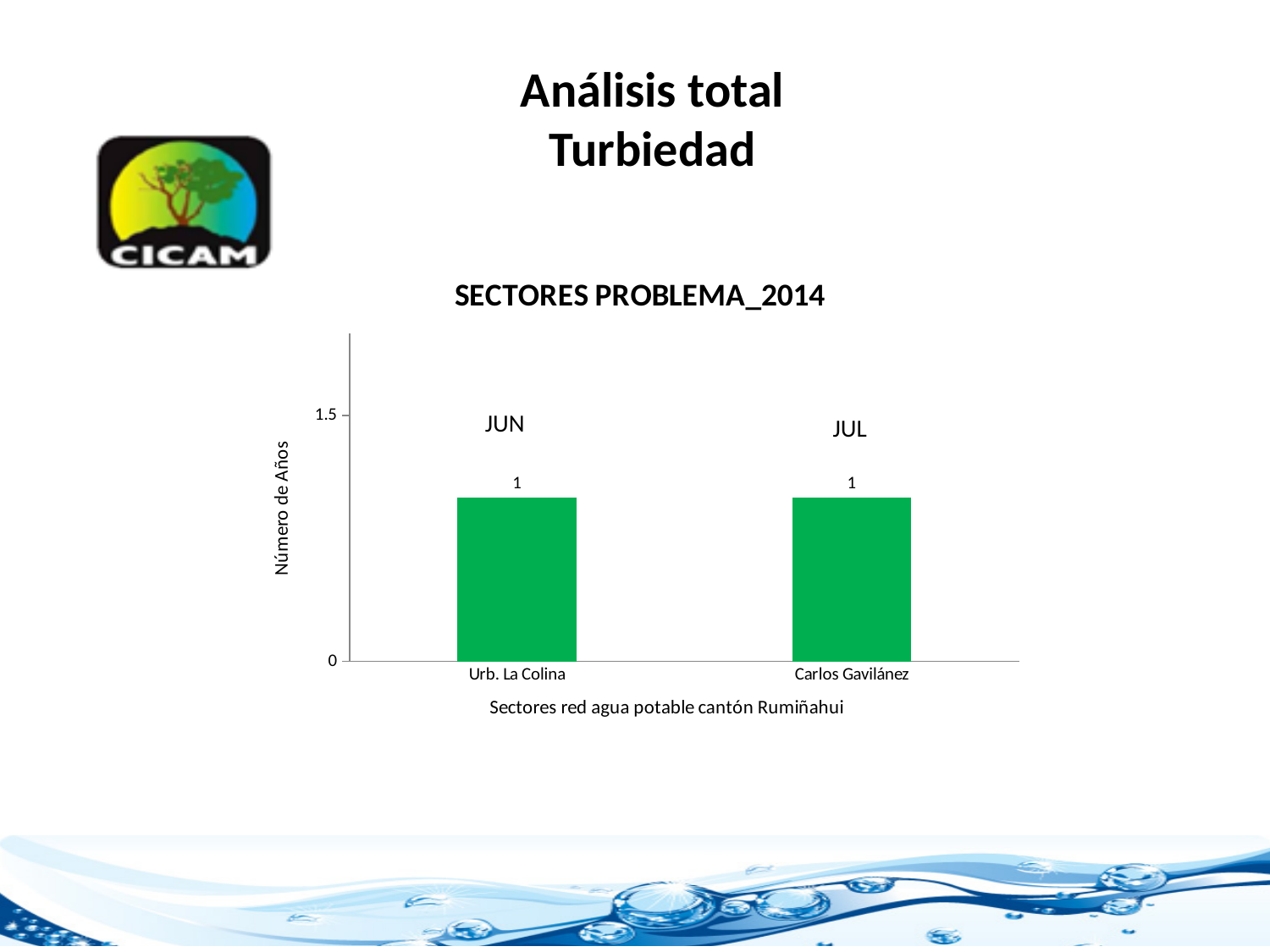
How many categories are shown on the x axis? 2 Which month label is shown above the bar for Carlos Gavilánez? JUL Is the value for Carlos Gavilánez greater or less than 1.5? less What is the title of the chart? SECTORES PROBLEMA_2014 What is the value for Urb. La Colina? 1 Which month label is shown above the bar for Urb. La Colina? JUN What is the label of the y axis? Número de Años What kind of chart is shown on the slide? bar chart What is the value for Carlos Gavilánez? 1 Is the value for Urb. La Colina greater or less than 1.5? less What is the difference between the values for Urb. La Colina and Carlos Gavilánez? 0